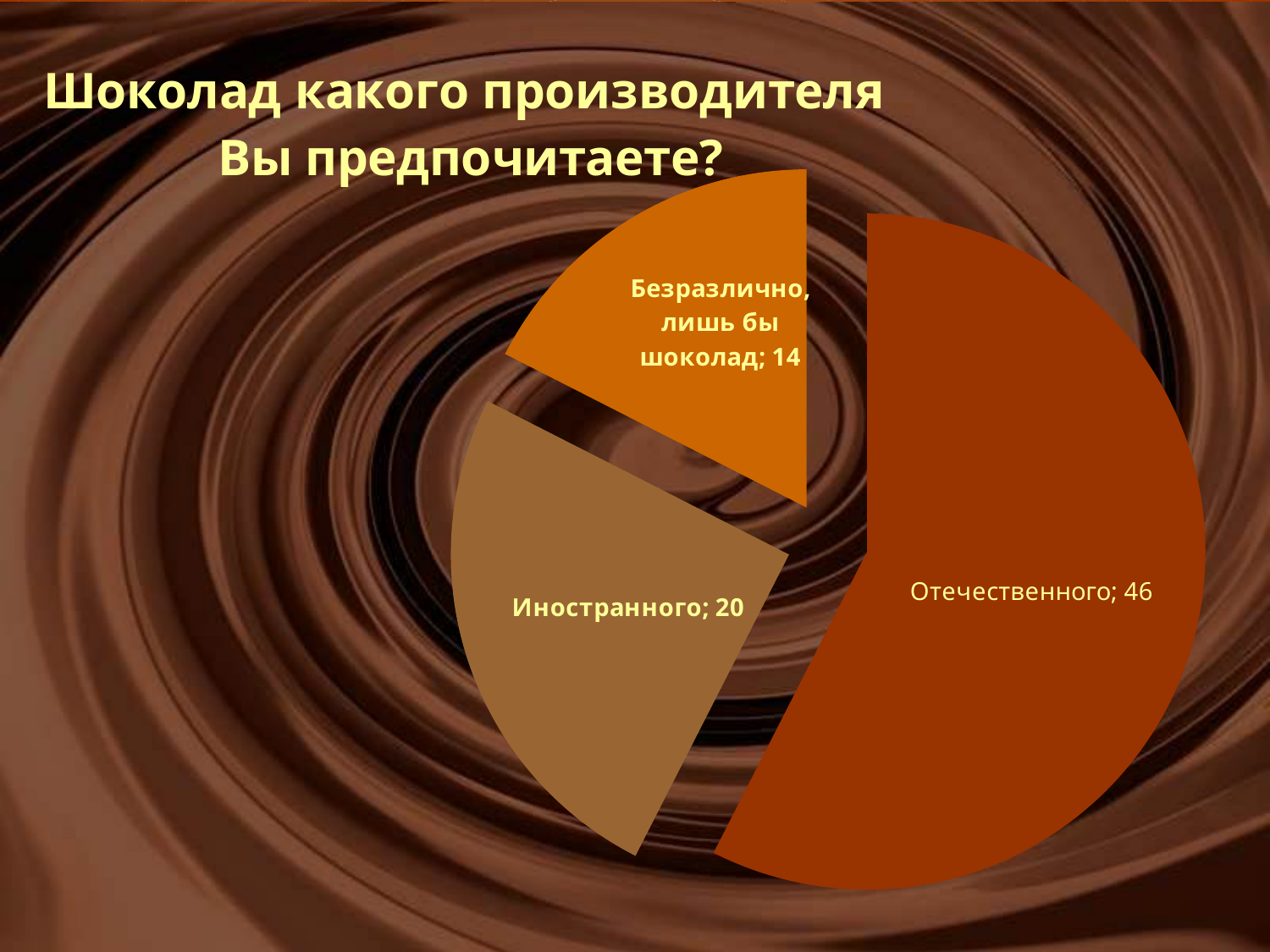
What is the value for "Отечественного"? 46 What is the value for "Иностранного"? 20 Which category has the largest slice of the pie? Отечественного What is the difference between the values for "Отечественного" and "Иностранного"? 26 What share of the pie does "Иностранного" represent? 25% What is the value for "Безразлично, лишь бы шоколад"? 14 What is the title of the chart on the slide? Шоколад какого производителя Вы предпочитаете? What is the difference between the values for "Иностранного" and "Безразлично, лишь бы шоколад"? 6 What kind of chart is shown on the slide? Pie chart Which category has the smallest slice of the pie? Безразлично, лишь бы шоколад How many categories does the pie chart have? 3 Which is larger, the value for "Иностранного" or the value for "Безразлично, лишь бы шоколад"? Иностранного